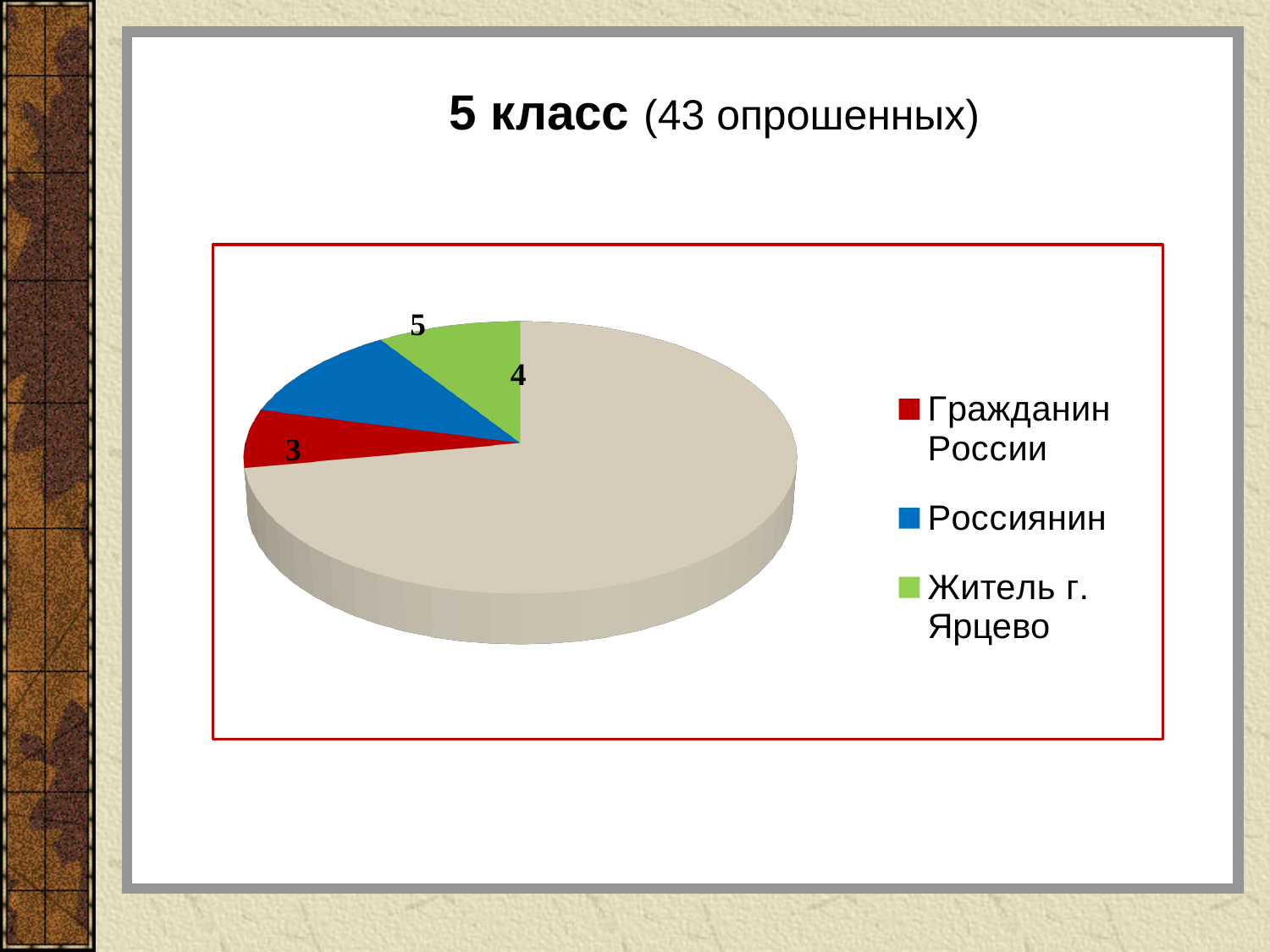
Among the categories listed in the legend, which has the highest value? Россиянин What is the value for Гражданин России? 3 What type of chart is shown on the slide? pie chart What is the title of the slide above the chart? 5 класс (43 опрошенных) Among the categories listed in the legend, which has the lowest value? Гражданин России What is the value for Россиянин? 5 How many categories does the legend list? 3 What is the value for Житель г. Ярцево? 4 What is the difference between the values for Россиянин and Житель г. Ярцево? 1 What colour is the slice for Россиянин? blue What is the difference between the values for Россиянин and Гражданин России? 2 Which is larger, the value for Житель г. Ярцево or the value for Гражданин России? Житель г. Ярцево